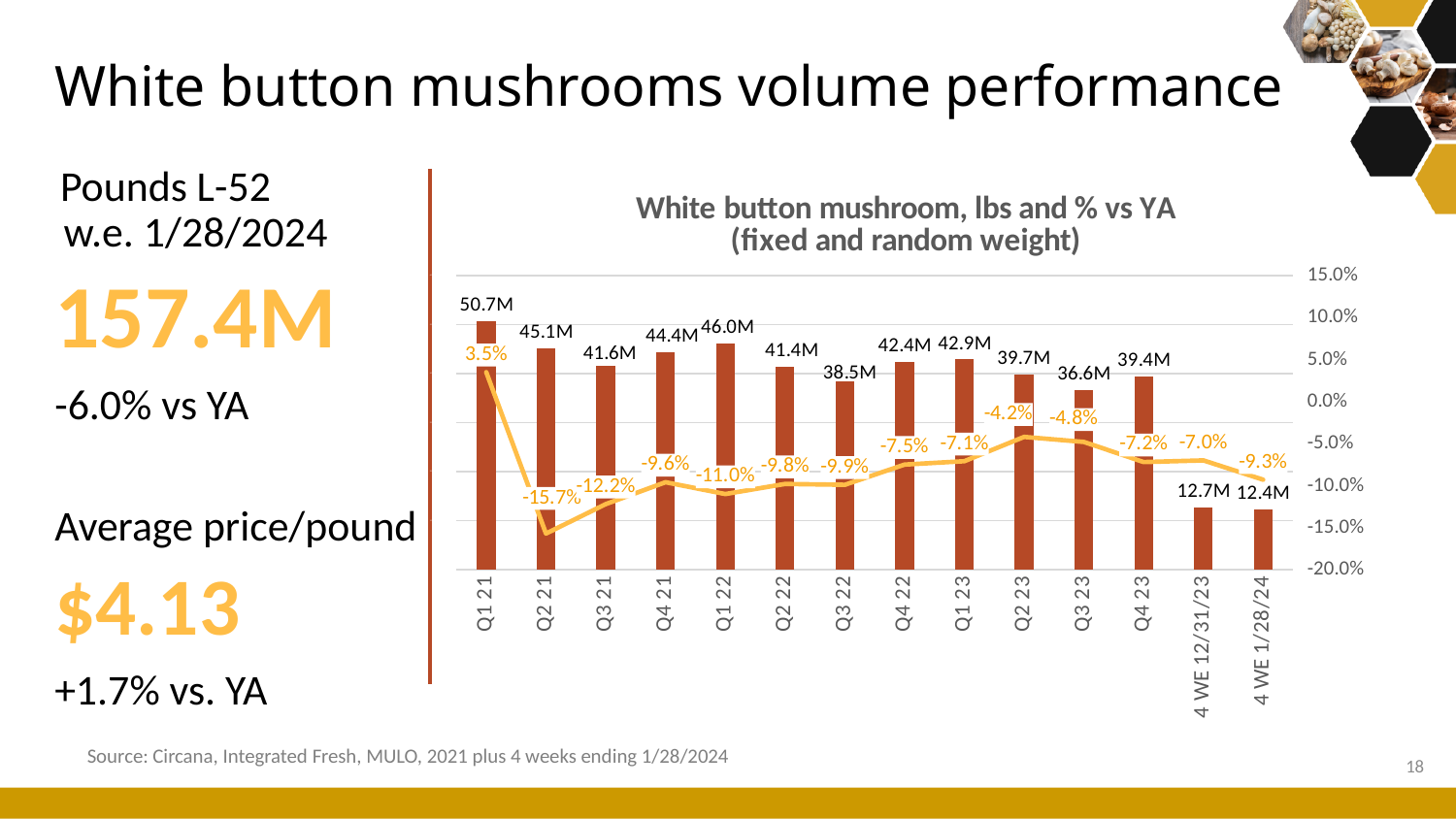
How many periods are shown on the x axis? 14 Which quarter has the highest volume in pounds? Q1 21 Which has the larger volume in pounds, Q4 22 or Q1 23? Q1 23 What is the % vs YA value for Q2 21? -15.7% Do the volume bars generally rise or fall from Q1 21 to Q4 23? Fall What is the % vs YA value for Q2 23? -4.2% Which period has the lowest % vs YA value? Q2 21 What is the difference in pounds between Q1 23 and Q2 23? 3.1M What kind of chart is this? Combination bar and line chart What is the volume in pounds for Q1 21? 50.7M What is the volume in pounds for the 4 WE 1/28/24 period? 12.4M What is the title of the chart? White button mushroom, lbs and % vs YA (fixed and random weight)